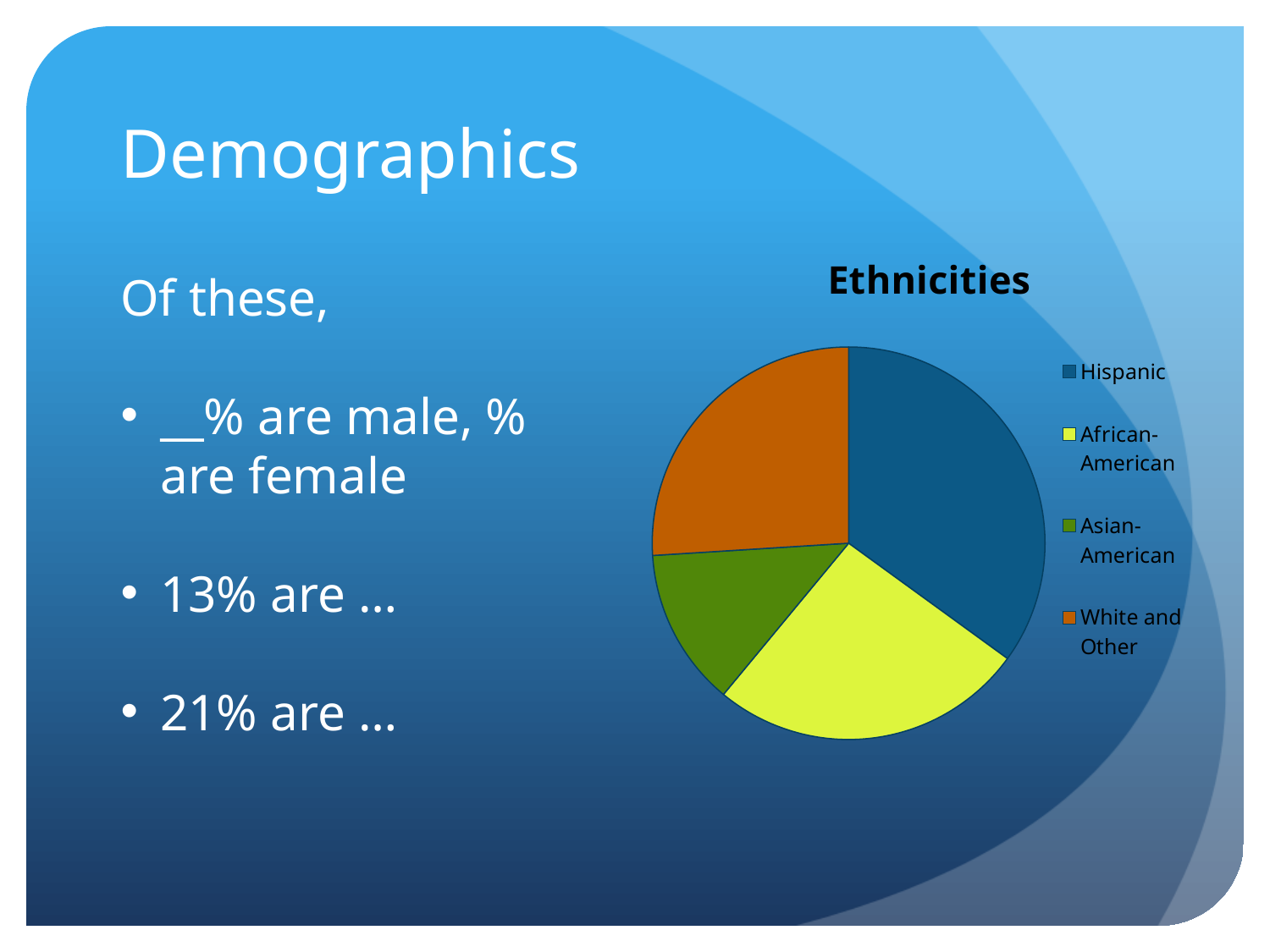
Which category has the largest slice in the Ethnicities pie chart? Hispanic Which slice is larger, Hispanic or African-American? Hispanic How many slices does the Ethnicities pie chart have? 4 What is the title of the chart? Ethnicities Which category has the smallest slice in the Ethnicities pie chart? Asian-American Which slice is larger, African-American or Asian-American? African-American Which slice is larger, Hispanic or White and Other? Hispanic What kind of chart is shown on the slide? pie chart Which category is shown in orange in the Ethnicities pie chart? White and Other